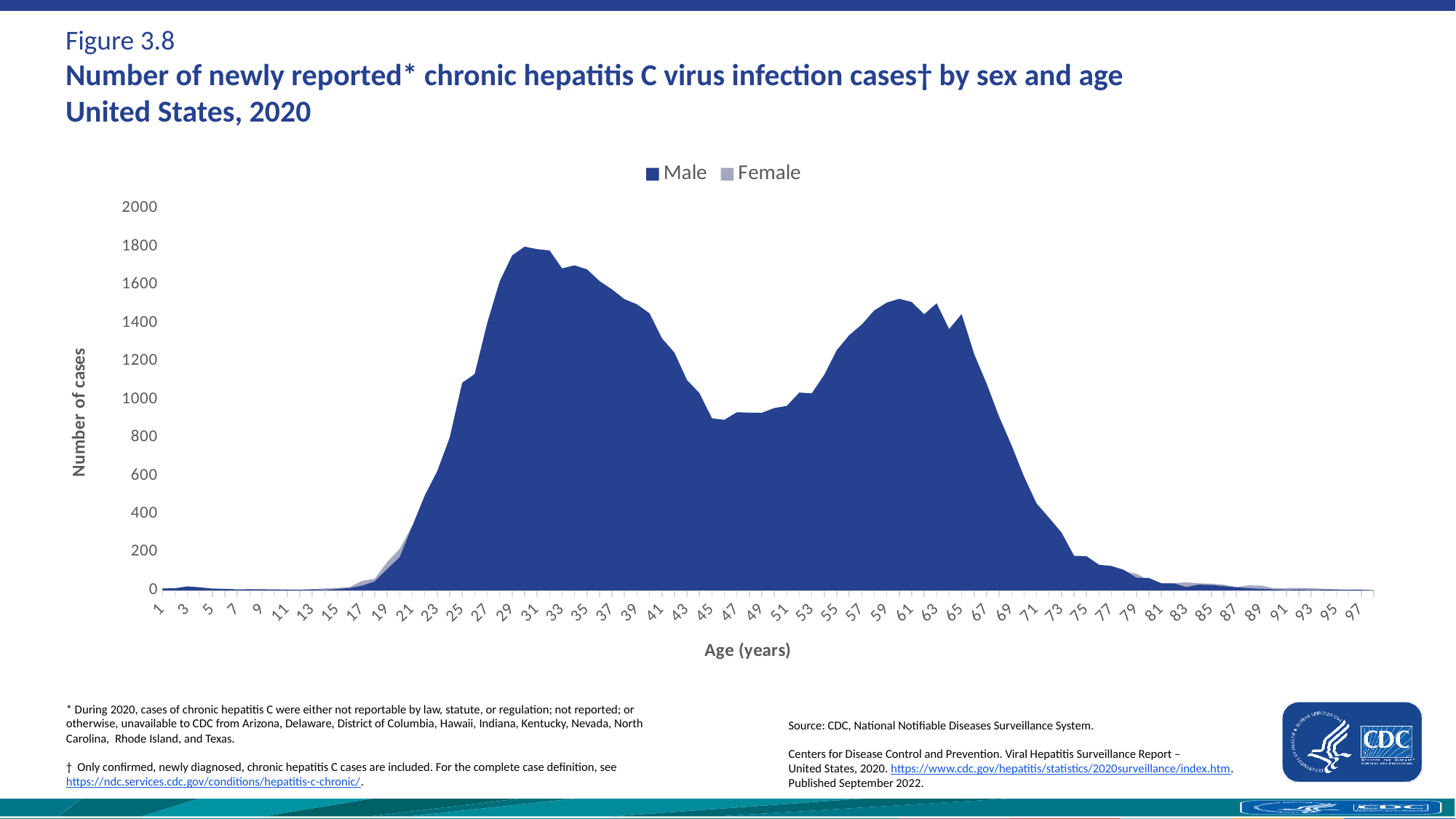
Is the Male value at age 45 greater or less than 1000? less Is the Male value at age 31 greater or less than 1600? greater What is the label of the vertical axis? Number of cases What kind of chart is shown on the slide? area chart Which is higher for the Male series, the peak around age 31 or the peak around age 61? the peak around age 31 Is the Male value at age 19 greater or less than 200? less How many series does the legend list? 2 Between ages 31 and 45, do the Male values rise or fall as age increases? fall What are the two series named in the legend? Male and Female